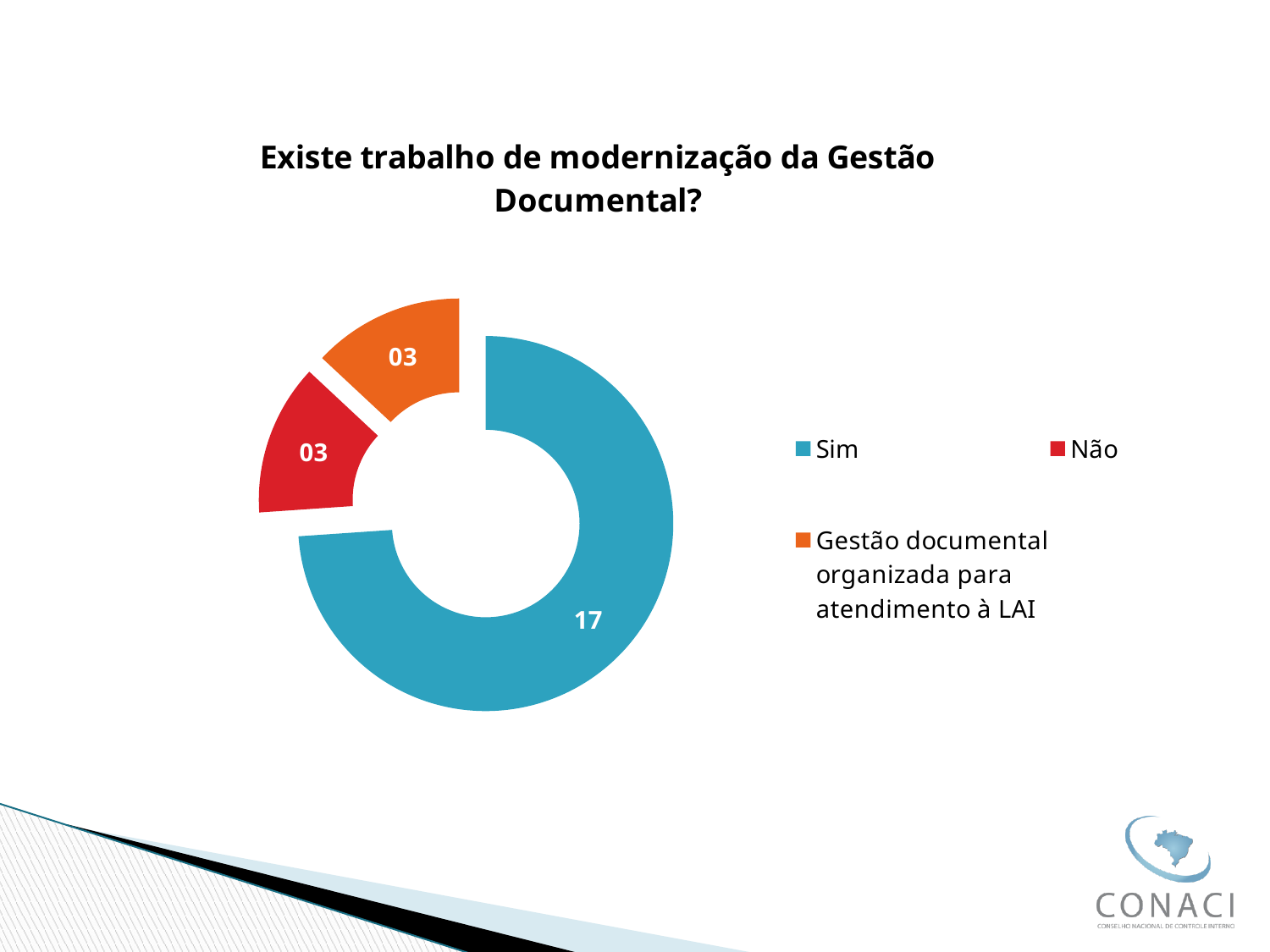
Which category has the largest slice? Sim How many slices does the chart have? 3 What colour is the "Sim" slice? blue What value is shown for the "Sim" slice? 17 What kind of chart is shown on the slide? doughnut chart What is the difference between the values for "Sim" and "Não"? 14 What value is shown for the "Gestão documental organizada para atendimento à LAI" slice? 03 How many entries does the legend list? 3 What is the total of all the slice values in the chart? 23 Which is larger, the value for "Sim" or the value for "Não"? Sim What is the title of the chart? Existe trabalho de modernização da Gestão Documental? What value is shown for the "Não" slice? 03